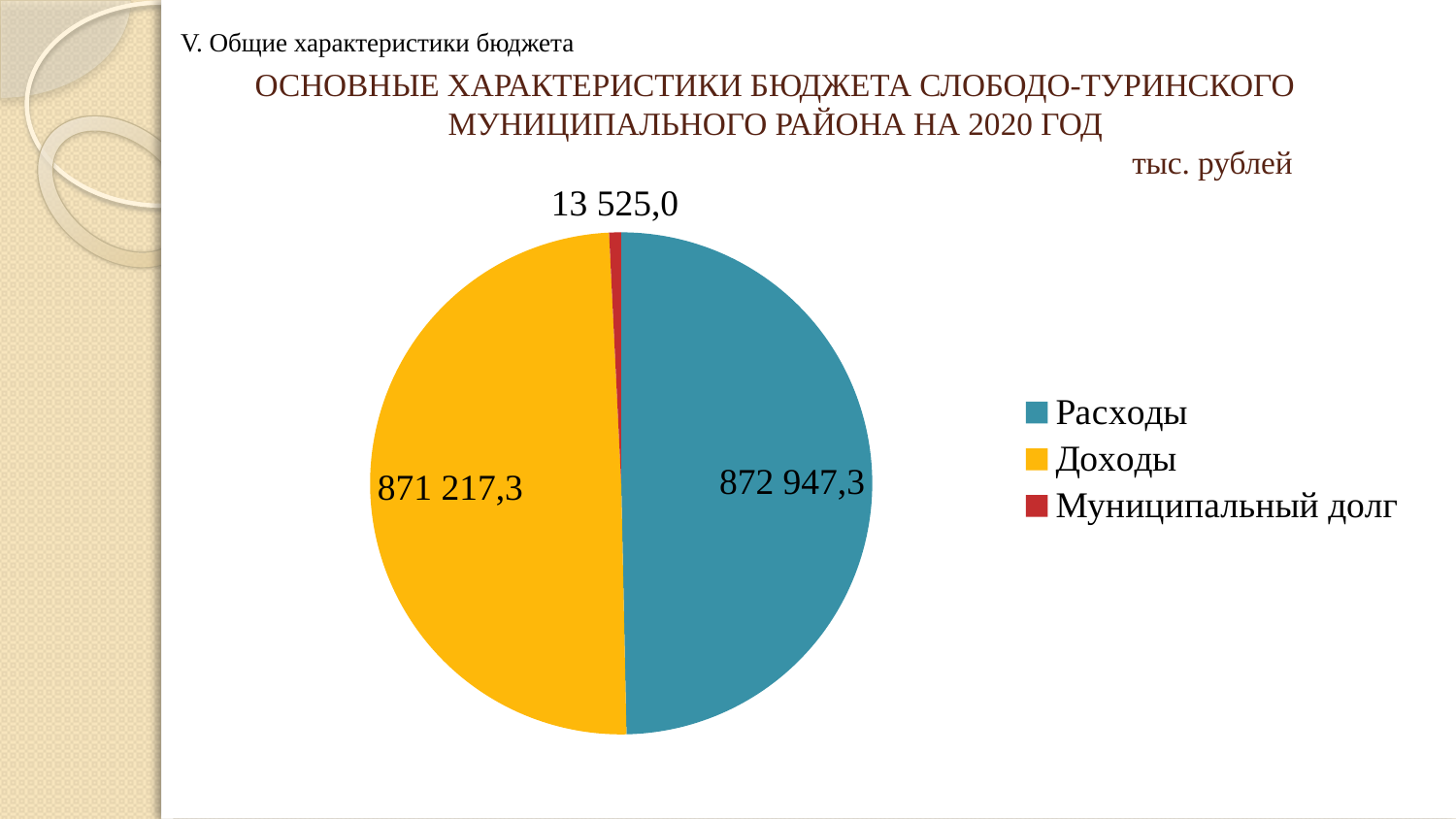
What is the value for Муниципальный долг in the pie chart? 13 525,0 How many slices does the pie chart have? 3 How many entries does the legend list? 3 Which category has the smallest slice in the pie chart? Муниципальный долг What is the difference between the values for Расходы and Доходы? 1 730,0 What is the value for Расходы in the pie chart? 872 947,3 What kind of chart is shown on the slide? Pie chart What is the value for Доходы in the pie chart? 871 217,3 What colour is the slice for Муниципальный долг? Red Which is larger, the value for Доходы or the value for Муниципальный долг? Доходы In what units are the values on the chart given? тыс. рублей What is the difference between the values for Доходы and Муниципальный долг? 857 692,3